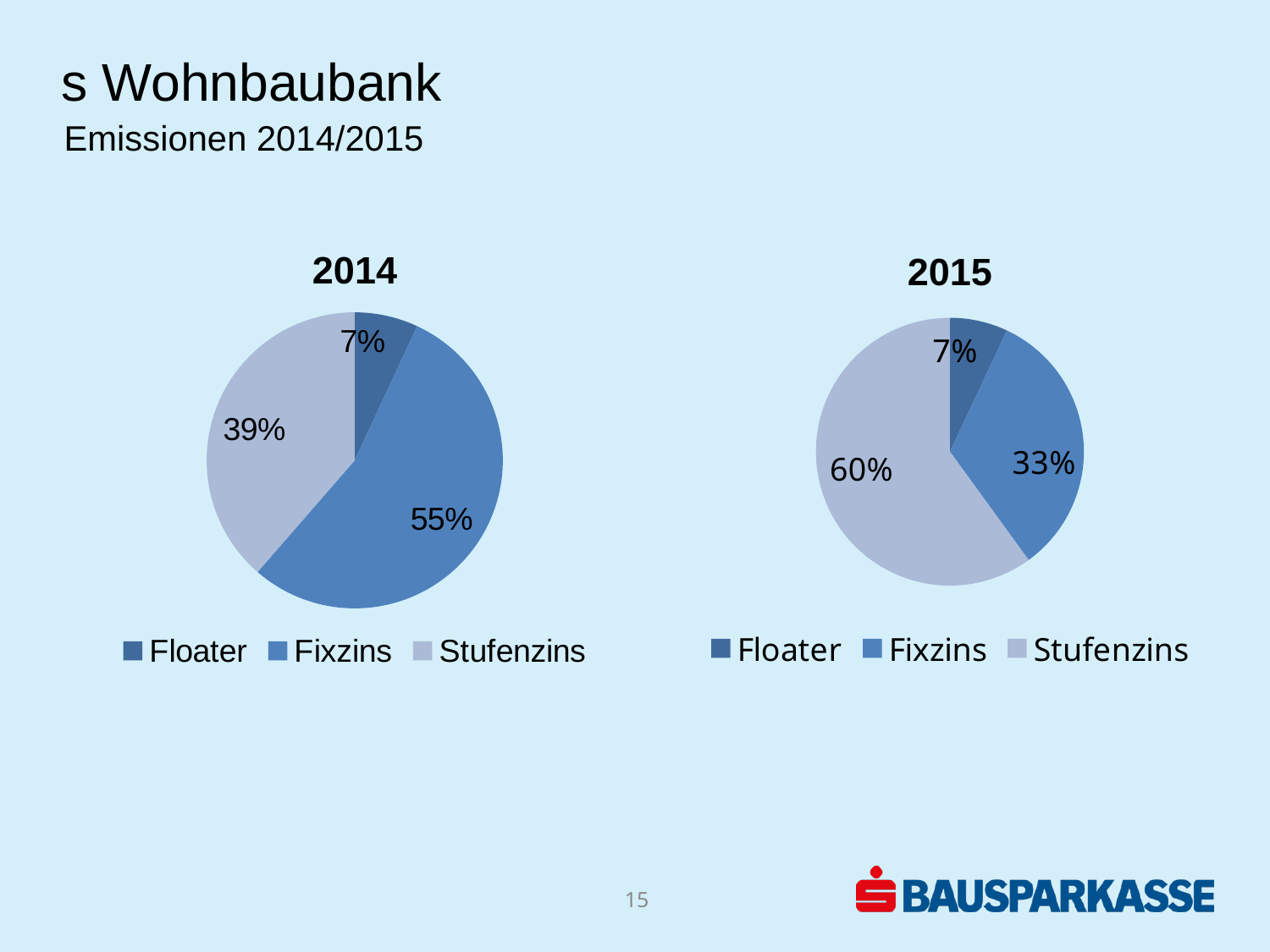
In the 2015 pie chart, is the share for Stufenzins larger or smaller than the share for Fixzins? larger In the 2015 pie chart, what share does Floater have? 7% In the 2014 pie chart, what share does Fixzins have? 55% In the 2015 pie chart, which category has the largest share? Stufenzins In the 2015 pie chart, what share does Fixzins have? 33% What kind of chart is the 2015 chart? pie chart In the 2014 pie chart, what share does Stufenzins have? 39% In the 2014 pie chart, which category has the smallest share? Floater In the 2014 pie chart, what is the difference between the Fixzins and Stufenzins shares? 16% In the 2014 pie chart, which category has the largest share? Fixzins In the 2015 pie chart, what share does Stufenzins have? 60% How many categories does the legend of the 2014 pie chart list? 3